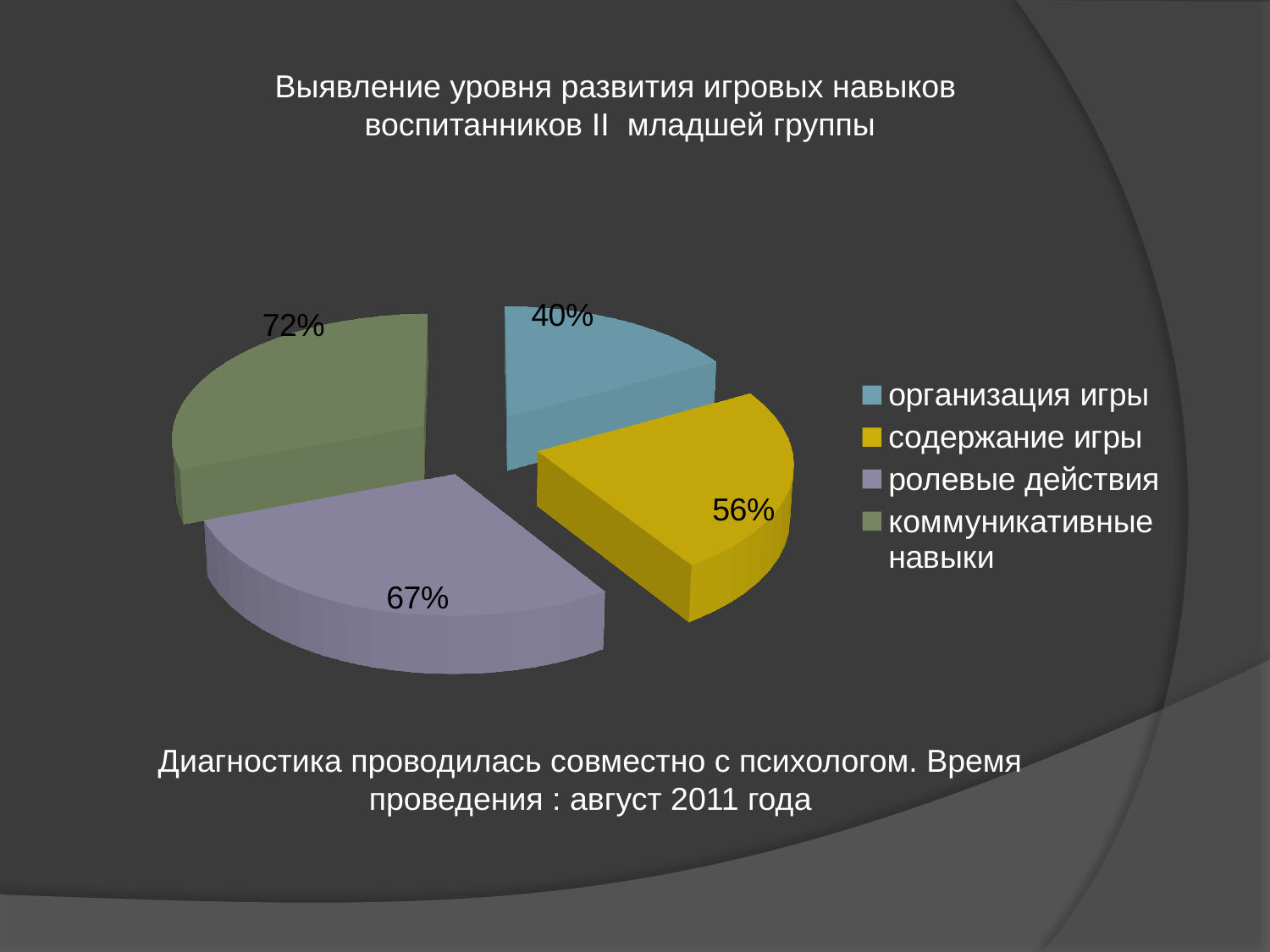
What colour is the slice for содержание игры? yellow What value is shown for организация игры? 40% What is the difference between the values for коммуникативные навыки and организация игры? 32% What kind of chart is shown on the slide? pie chart What value is shown for коммуникативные навыки? 72% Which category has the lowest value? организация игры What value is shown for ролевые действия? 67% What is the difference between the values for ролевые действия and содержание игры? 11% How many categories does the pie chart have? 4 What value is shown for содержание игры? 56% Which category has the highest value? коммуникативные навыки Which is larger, the value for содержание игры or the value for ролевые действия? ролевые действия